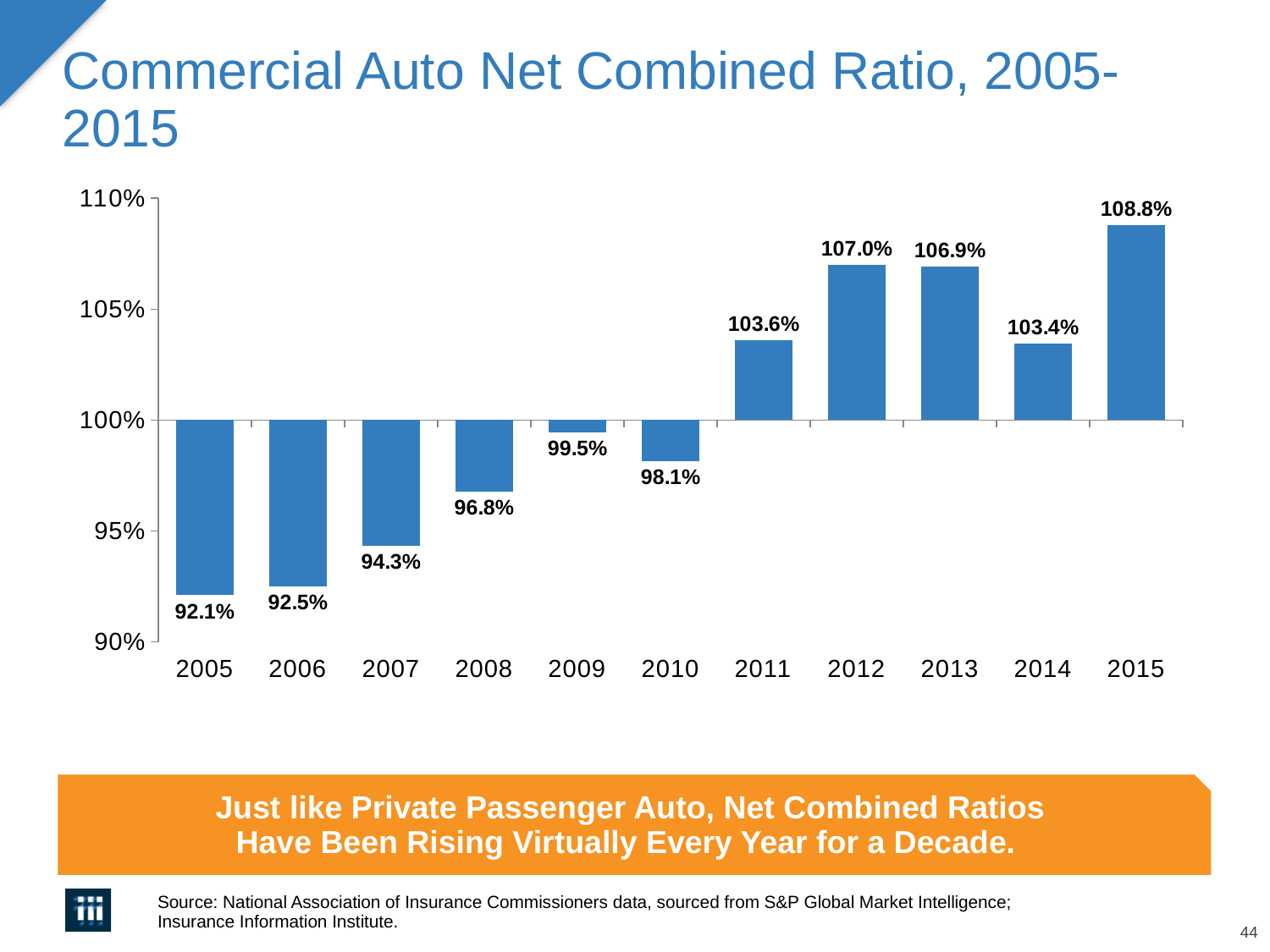
What is the difference between the net combined ratio in 2012 and in 2013? 0.1% What is the title of the chart on the slide? Commercial Auto Net Combined Ratio, 2005-2015 How many years are shown on the chart? 11 Is the net combined ratio for 2010 greater or less than 100%? less What was the commercial auto net combined ratio in 2008? 96.8% What is the overall trend of the net combined ratio from 2005 to 2015? Rising Which year had the lowest net combined ratio? 2005 What was the commercial auto net combined ratio in 2012? 107.0% Which year had the highest net combined ratio? 2015 What type of chart is shown on the slide? Bar chart Which year had a higher net combined ratio, 2011 or 2014? 2011 What is the difference between the net combined ratio in 2015 and in 2005? 16.7%